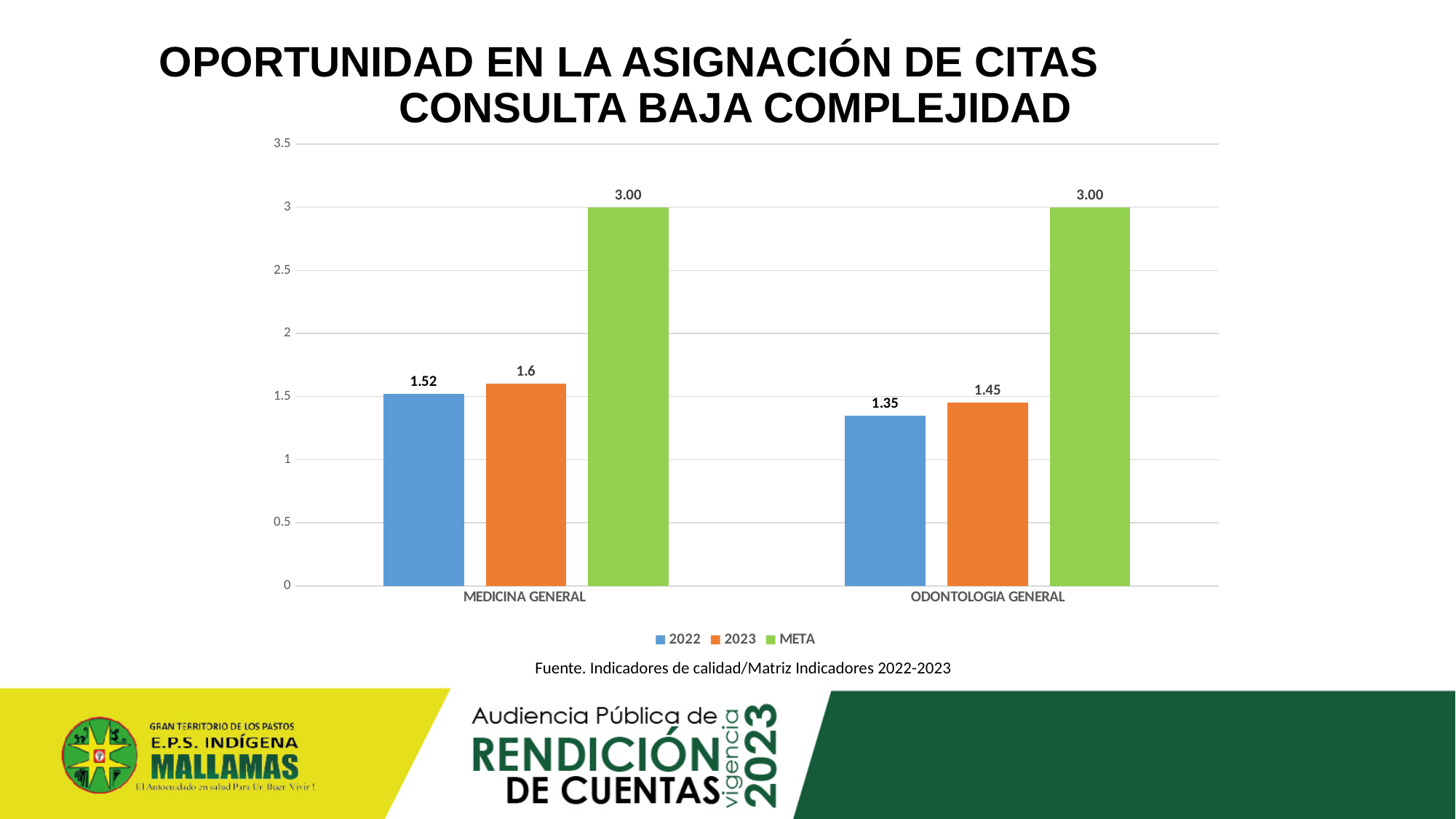
What is the difference between the 2023 and 2022 values for ODONTOLOGIA GENERAL? 0.1 Which category has the lowest 2022 value? ODONTOLOGIA GENERAL Which category has the highest 2023 value? MEDICINA GENERAL What is the 2023 value for ODONTOLOGIA GENERAL? 1.45 What kind of chart is shown on the slide? bar chart What is the META value for MEDICINA GENERAL? 3.00 Is the 2023 value for MEDICINA GENERAL greater or less than 2? less How many categories are shown on the x axis? 2 What is the 2022 value for MEDICINA GENERAL? 1.52 How many series does the legend list? 3 What is the 2022 value for ODONTOLOGIA GENERAL? 1.35 Which is larger for MEDICINA GENERAL, the 2022 value or the 2023 value? 2023